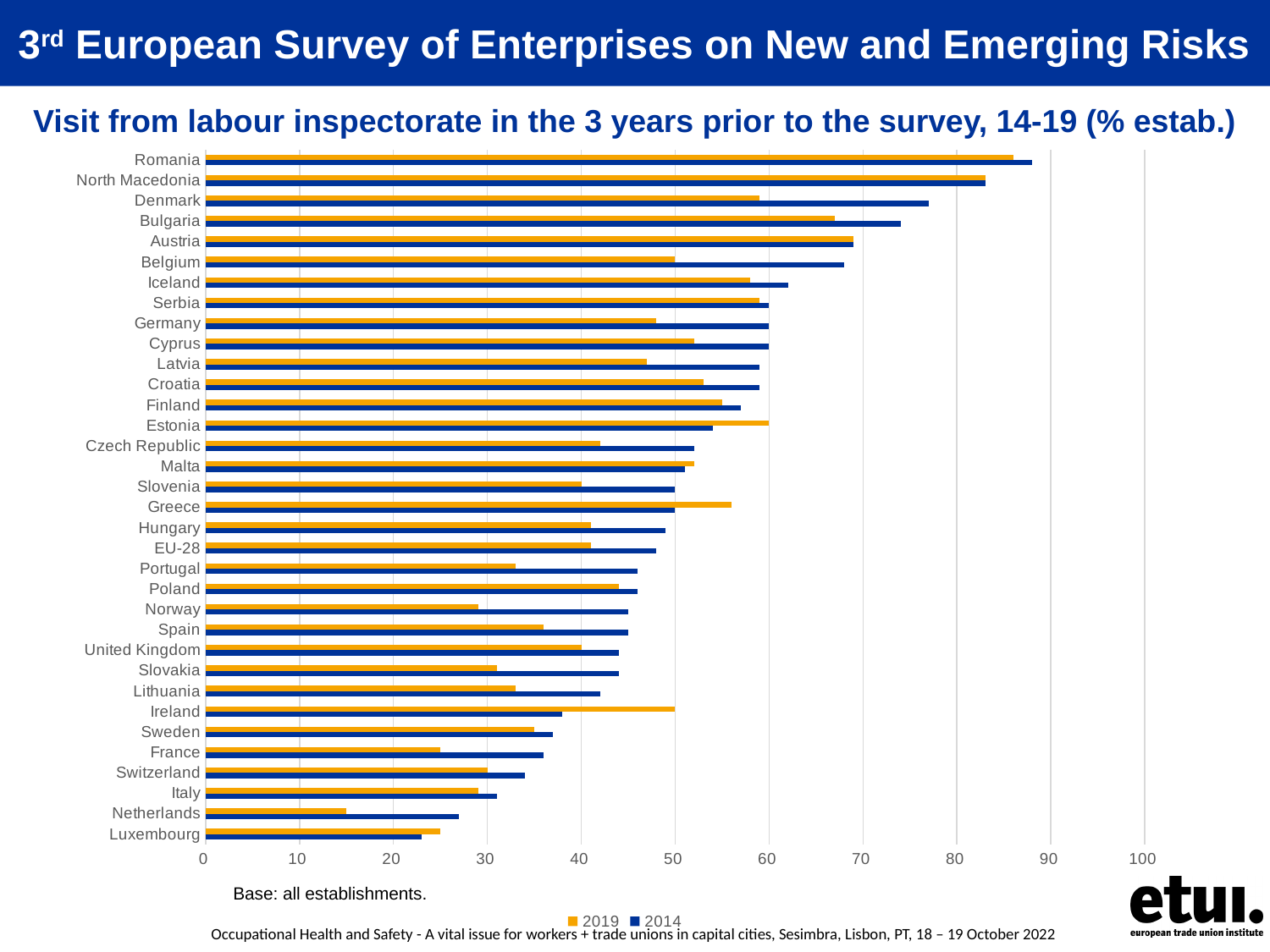
What kind of chart is shown on the slide? bar chart How many series does the legend list? 2 Is the 2019 value for the Netherlands greater or less than 20? less Which country has the lowest value for 2019? Netherlands Which country has the lowest value for 2014? Luxembourg For Ireland, which is larger: the 2019 value or the 2014 value? 2019 How many countries/regions are listed on the chart? 34 Which country has the highest value for 2014? Romania Is the 2014 value for Romania greater or less than 80? greater Is the 2014 value for Denmark greater or less than 70? greater For Denmark, which is larger: the 2019 value or the 2014 value? 2014 Which series is shown in orange in the legend? 2019